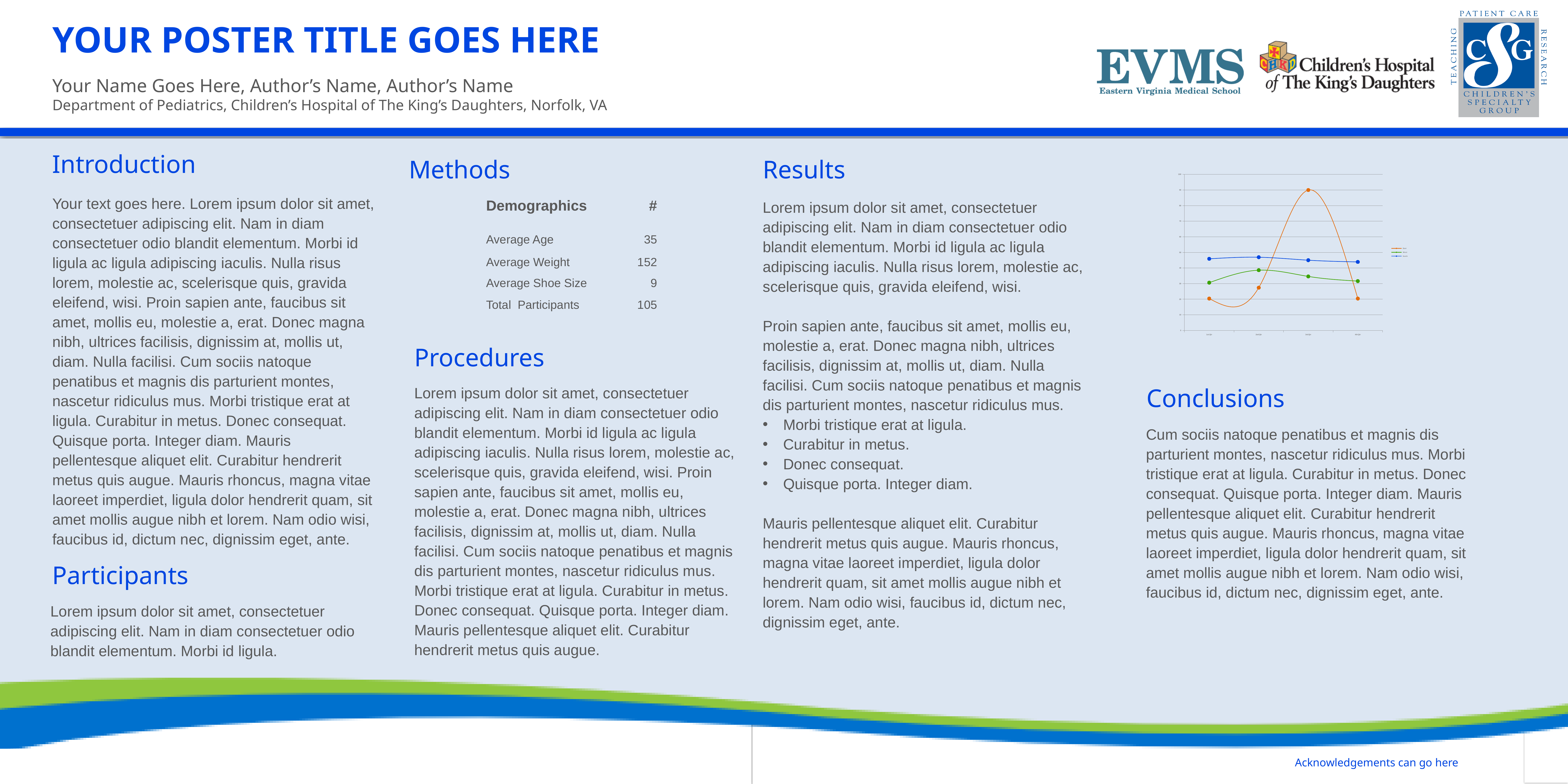
Which coloured line reaches the highest point on the chart? the orange line How many series does the legend of the line chart list? 3 Which coloured line has the lowest starting point on the left of the chart? the orange line At the first point on the left, is the blue line above or below the green line? above What kind of chart is shown in the Results section of the poster? line chart What colours are the three lines in the chart? blue, orange and green How many data points are plotted on each line of the chart? 4 Does the orange line rise steadily, fall steadily, or rise and then fall across the x axis? rise and then fall